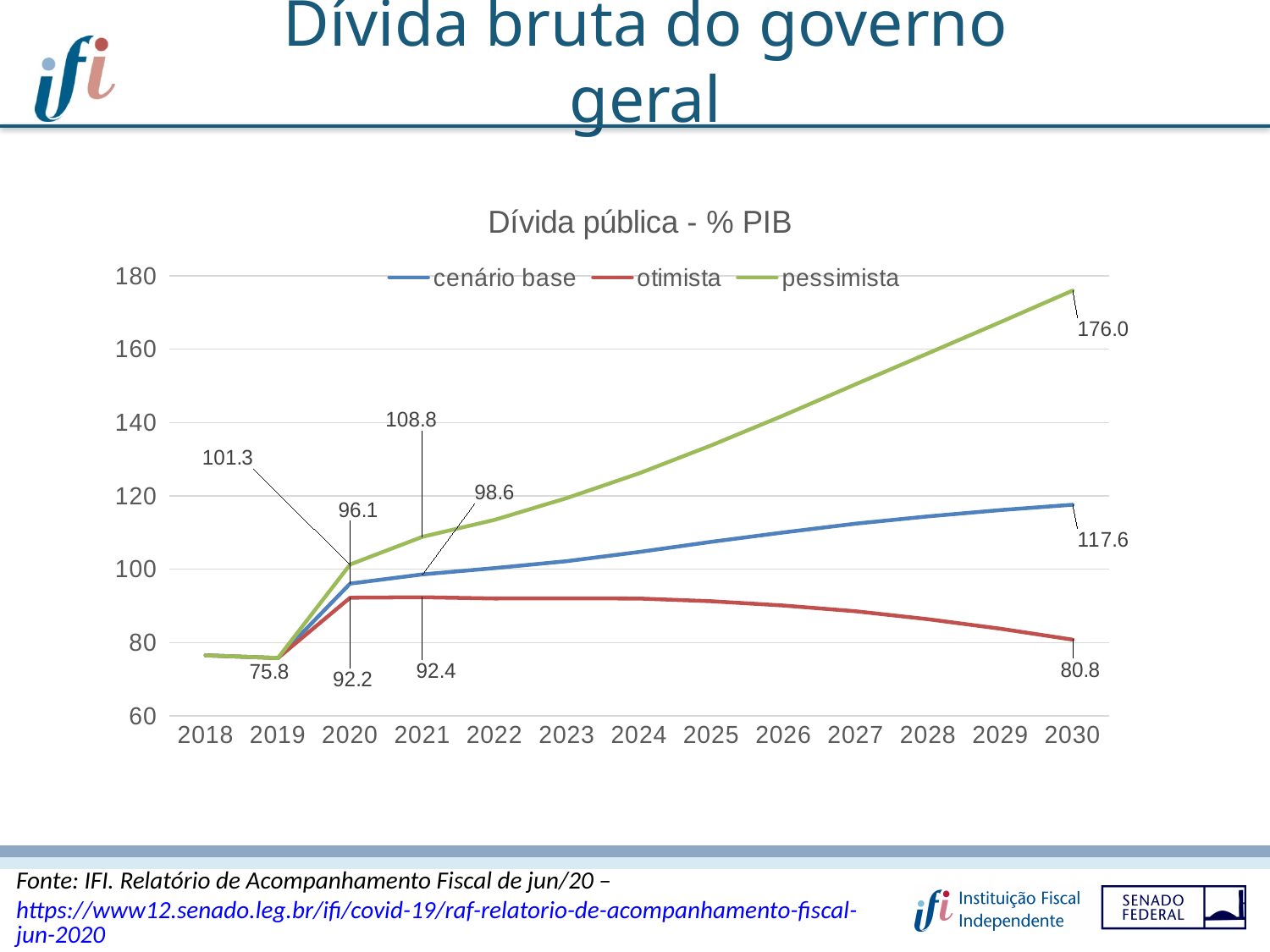
How many series does the legend list? 3 How many years are shown on the x axis? 13 What is the value of the otimista series in 2030? 80.8 What type of chart is shown on the slide? line chart What is the difference between the pessimista and cenário base values in 2030? 58.4 Which is larger in 2021, the cenário base value or the otimista value? cenário base What is the value of the pessimista series in 2030? 176.0 What is the value of the cenário base series in 2020? 96.1 What is the value of the cenário base series in 2030? 117.6 Does the otimista series rise or fall between 2021 and 2030? fall What is the value of the pessimista series in 2021? 108.8 Which series has the highest value in 2030? pessimista